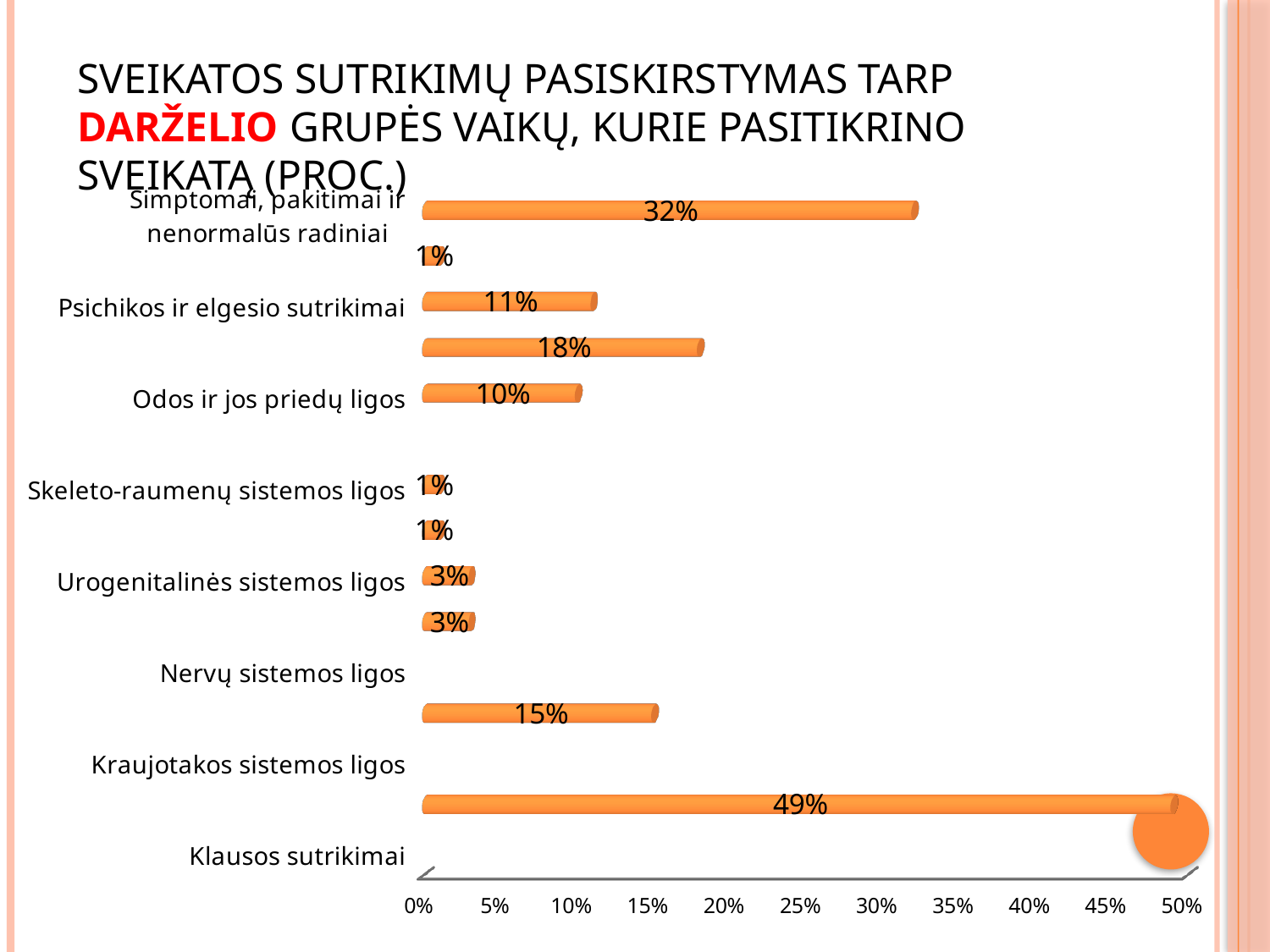
What is the second largest value shown on the chart? 32% What is the value for Skeleto-raumenų sistemos ligos? 1% What kind of chart is shown on the slide? bar chart Which word in the slide title is written in red? DARŽELIO Is the longest bar on the chart greater or less than 45%? greater What is the difference between the largest value (49%) and the second largest value (32%)? 17 percentage points What is the value for Odos ir jos priedų ligos? 10% What is the value for Psichikos ir elgesio sutrikimai? 11% What is the maximum value shown on the horizontal axis? 50% What is the largest value shown on the chart? 49% Which is larger, the value for Psichikos ir elgesio sutrikimai or the value for Odos ir jos priedų ligos? Psichikos ir elgesio sutrikimai What is the value for Urogenitalinės sistemos ligos? 3%